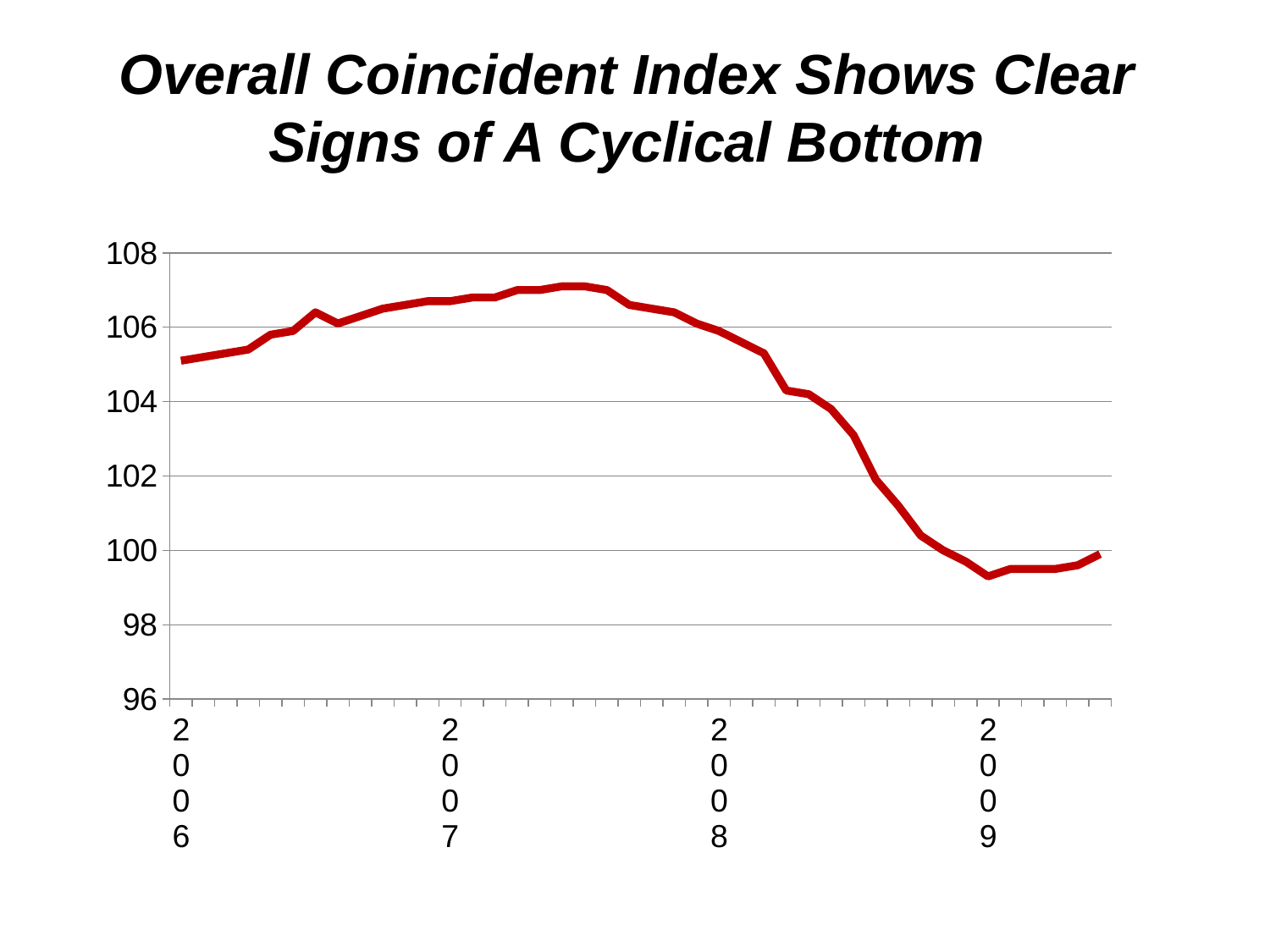
Is the value at the start of 2006 greater or less than 104? greater Is the lowest point of the line greater or less than 100? less Is the value at the start of 2008 greater or less than 104? greater Does the line rise or fall between the start of 2008 and the start of 2009? fall What is the title of the slide? Overall Coincident Index Shows Clear Signs of A Cyclical Bottom What kind of chart is shown on the slide? line chart What colour is the plotted line? red Of the labeled years 2006, 2007, 2008 and 2009, which has the lowest value at its x-axis tick? 2009 How many year labels are shown on the x axis? 4 Does the line rise or fall between the start of 2006 and the start of 2007? rise